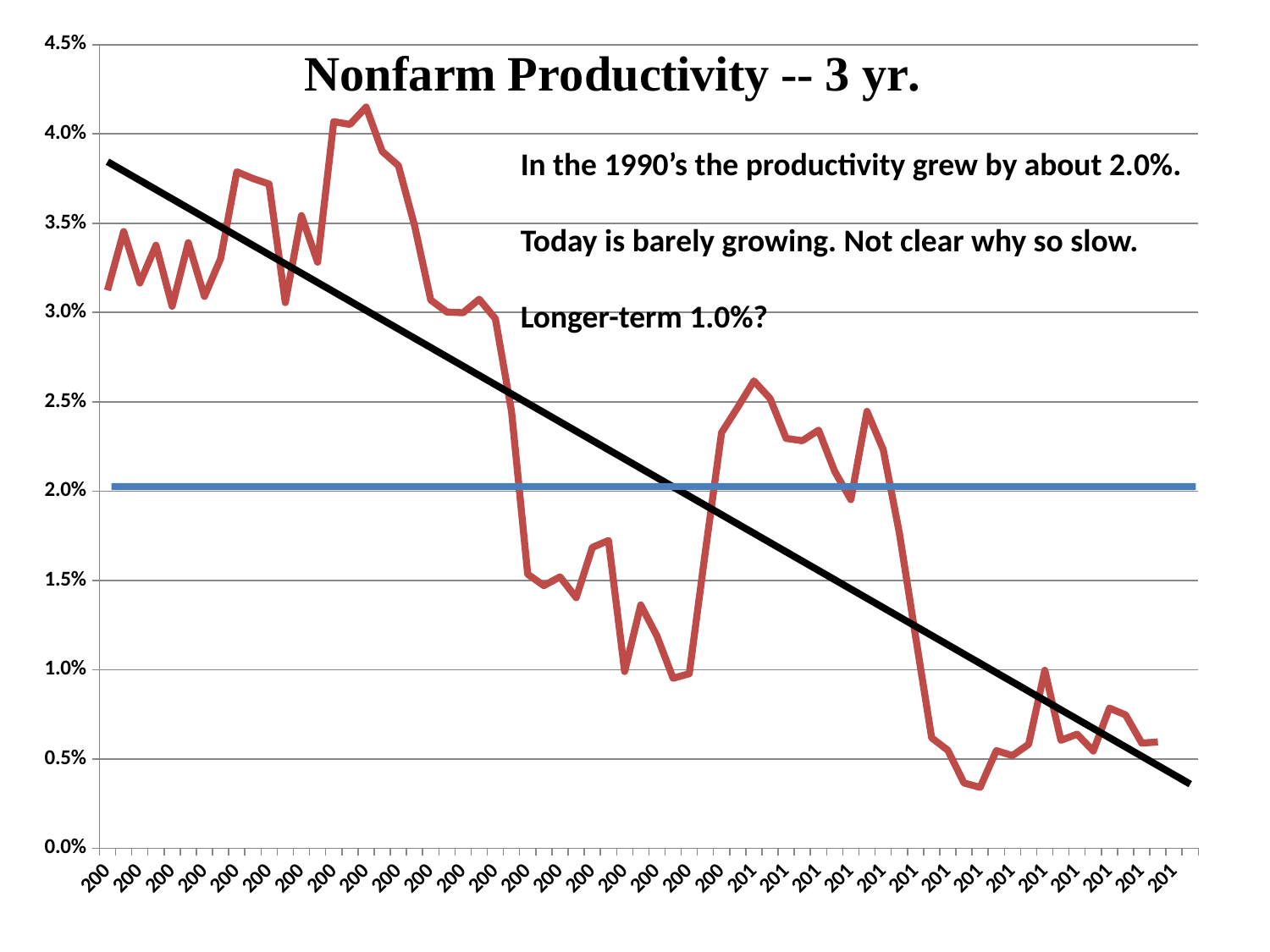
Is the value of the black trend line at the left edge of the chart greater or less than 3.5%? greater Is the value of the black trend line at the right edge of the chart greater or less than 0.5%? less Is the lowest point of the red line greater or less than 0.5%? less What is the highest value shown on the y axis? 4.5% What kind of chart is shown on the slide? line chart What is the title of the chart? Nonfarm Productivity -- 3 yr. Does the black straight trend line slope upward or downward from left to right? downward Does the red productivity line generally rise or fall from left to right along the x axis? fall